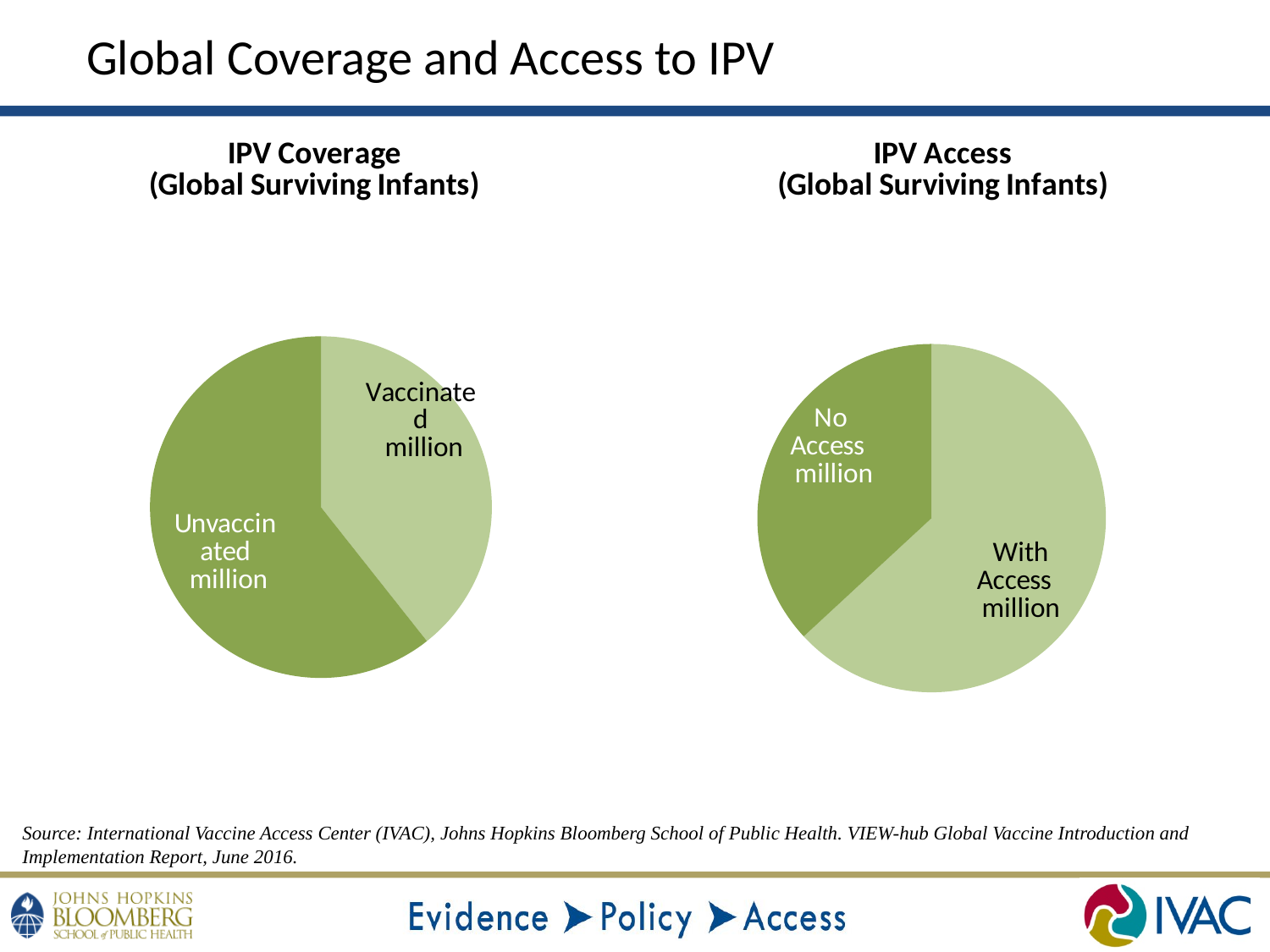
In the IPV Access (Global Surviving Infants) chart, which slice is the smallest? No Access In the IPV Coverage (Global Surviving Infants) chart, which is larger, the Vaccinated slice or the Unvaccinated slice? Unvaccinated What is the title of the pie chart on the right of the slide? IPV Access (Global Surviving Infants) In the IPV Access (Global Surviving Infants) chart, how many slices does the pie have? 2 In the IPV Access (Global Surviving Infants) chart, which slice is the largest? With Access What kind of chart is the IPV Coverage (Global Surviving Infants) chart on the left? Pie chart In the IPV Coverage (Global Surviving Infants) chart, which slice is the largest? Unvaccinated What is the title of the pie chart on the left of the slide? IPV Coverage (Global Surviving Infants) In the IPV Coverage (Global Surviving Infants) chart, how many slices does the pie have? 2 In the IPV Coverage (Global Surviving Infants) chart, which slice is the smallest? Vaccinated What kind of chart is the IPV Access (Global Surviving Infants) chart on the right? Pie chart In the IPV Access (Global Surviving Infants) chart, which is larger, the With Access slice or the No Access slice? With Access